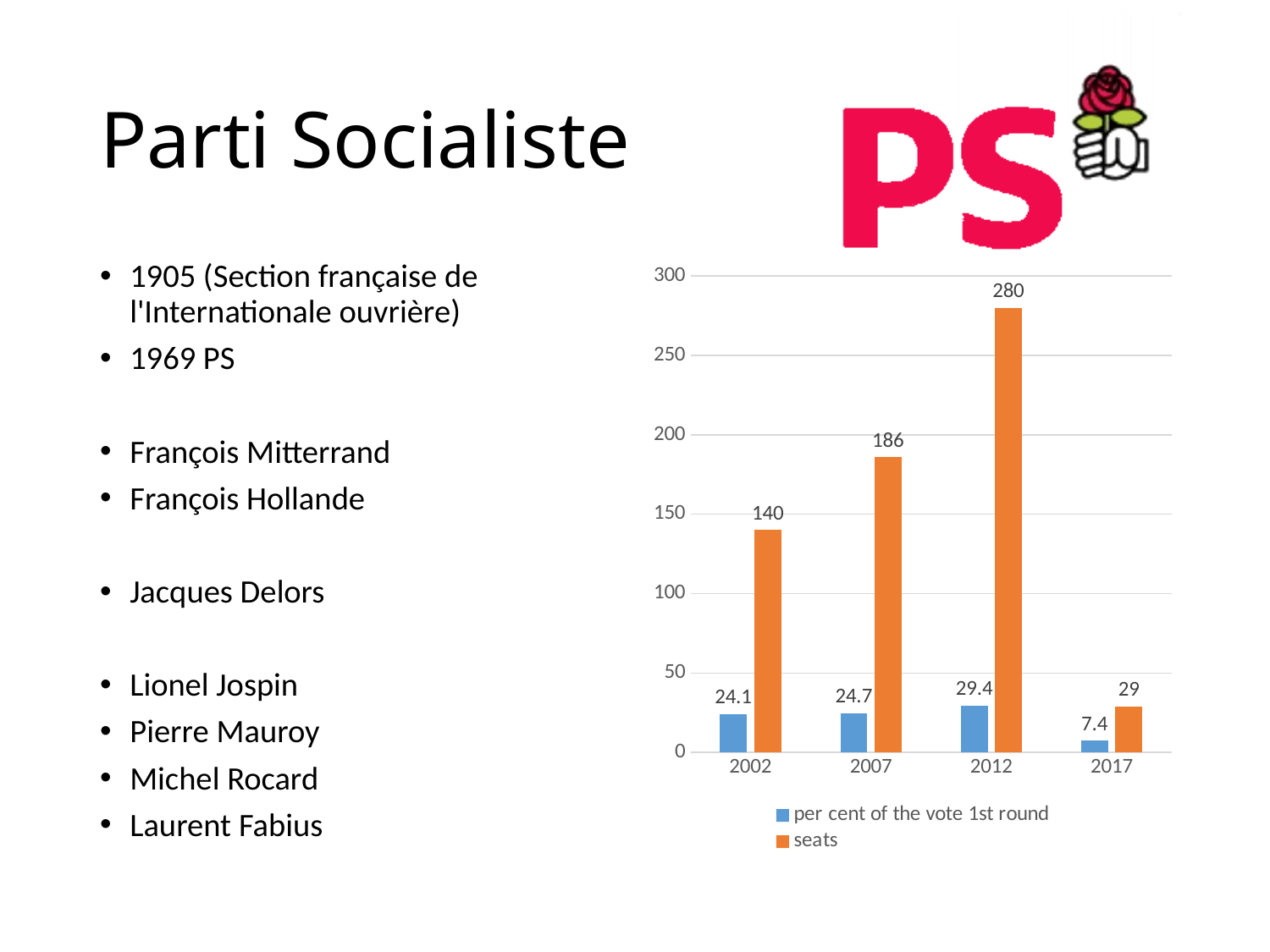
In which year was the number of seats highest? 2012 What is the difference in seats between 2012 and 2017? 251 Which colour represents the seats series? orange What was the per cent of the vote in the 1st round in 2017? 7.4 Which year had more seats, 2002 or 2007? 2007 In which year was the per cent of the vote in the 1st round lowest? 2017 How many series does the legend list? 2 Did the number of seats rise or fall from 2012 to 2017? fall What kind of chart is shown on the slide? bar chart How many seats did the party win in 2007? 186 How many seats did the party win in 2012? 280 How many years are shown on the x axis? 4